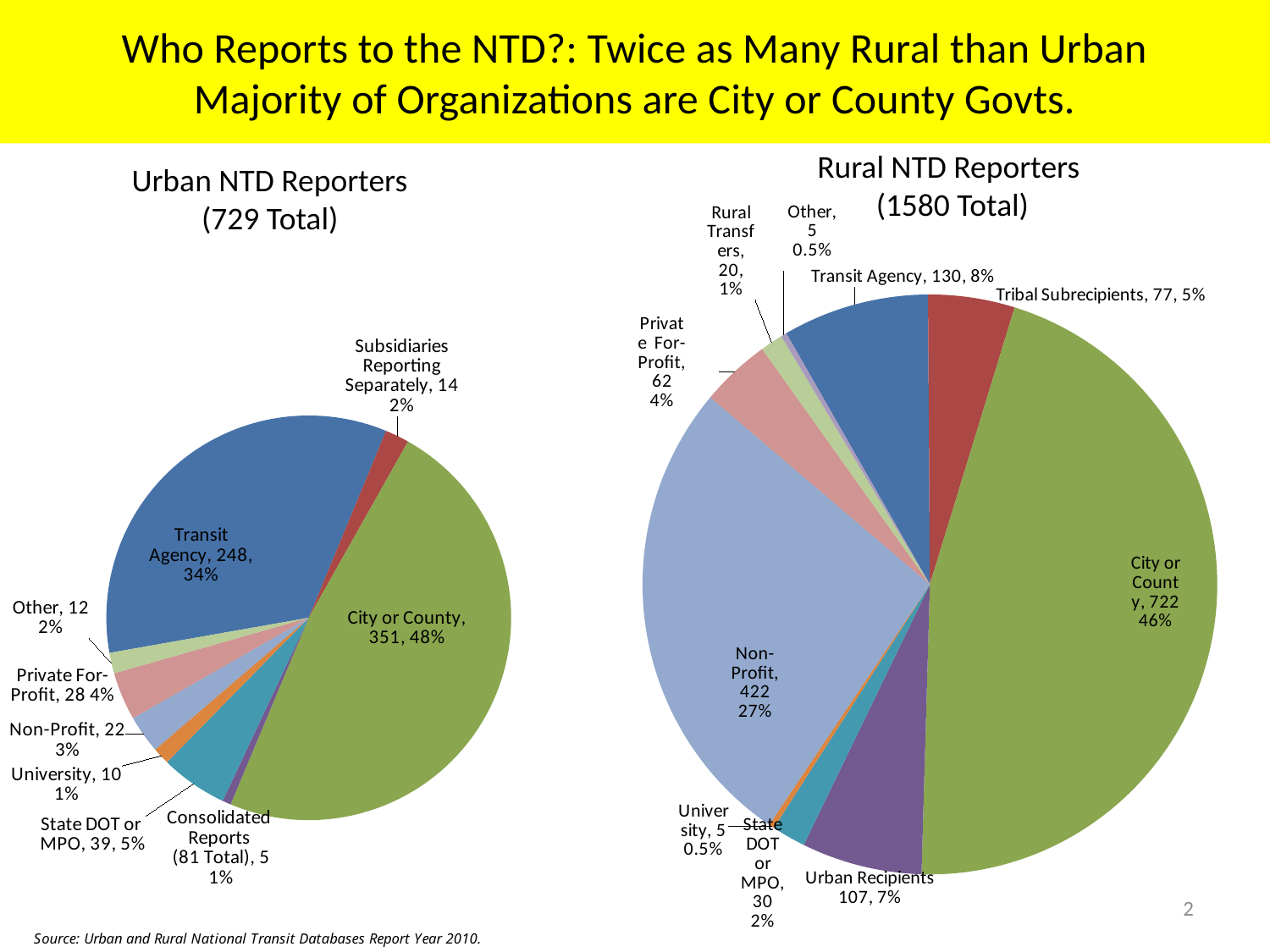
In the Urban NTD Reporters chart, what is the difference between the City or County count and the Transit Agency count? 103 In the Rural NTD Reporters chart, which category has the largest slice? City or County In the Rural NTD Reporters chart, what share of the pie is Non-Profit? 27% In the Rural NTD Reporters chart, how many Tribal Subrecipients are there? 77 In the Urban NTD Reporters chart, what share of the pie is Transit Agency? 34% What is the total number of reporters shown in the title of the Rural NTD Reporters chart? 1580 How many categories are shown in the Rural NTD Reporters chart? 10 In the Urban NTD Reporters chart, how many organizations are City or County? 351 In the Rural NTD Reporters chart, which is larger: Transit Agency or Urban Recipients? Transit Agency In the Urban NTD Reporters chart, which category has the smallest slice? Consolidated Reports What kind of chart is the Urban NTD Reporters chart? Pie chart How many categories are shown in the Urban NTD Reporters chart? 9